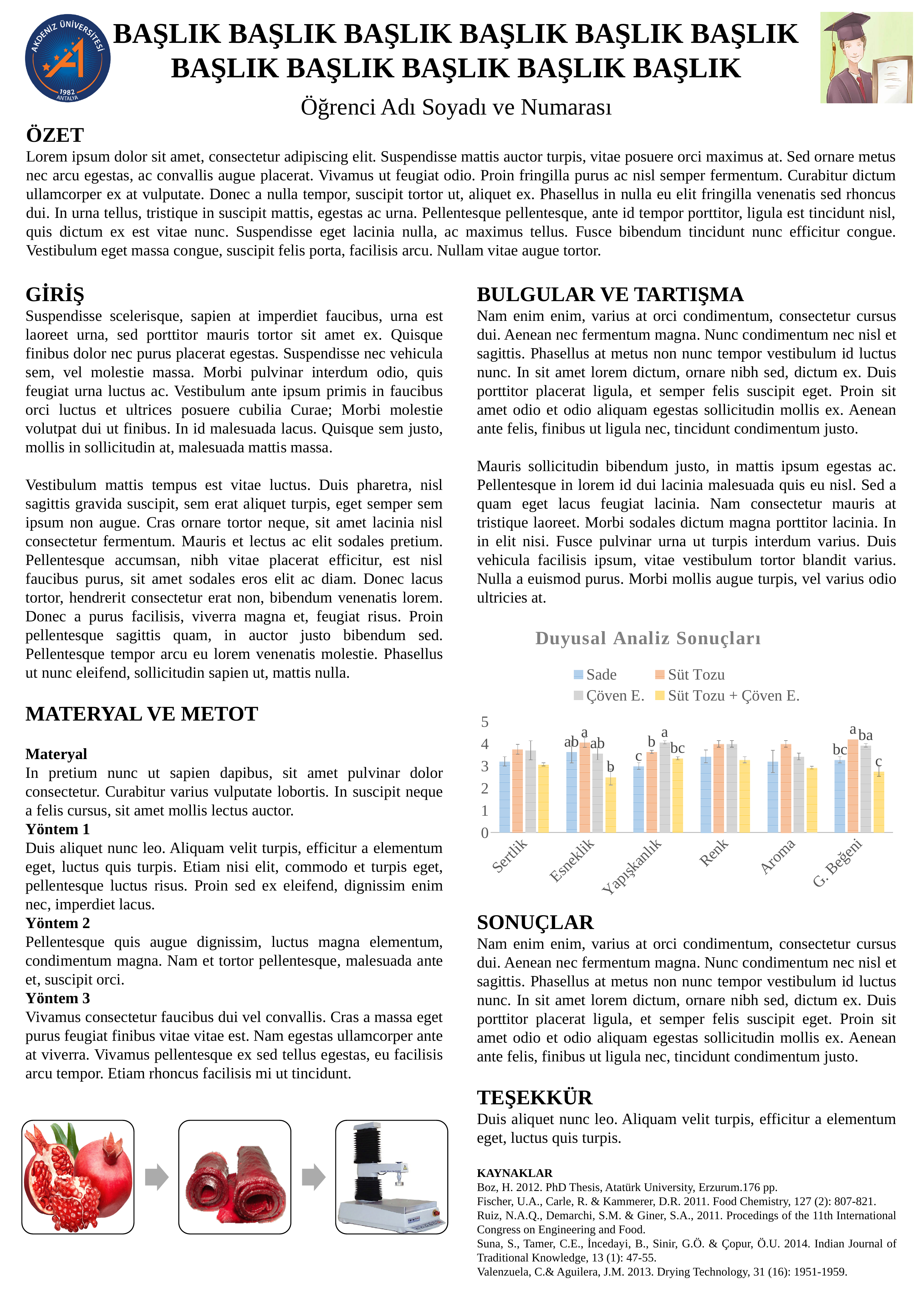
How many series does the legend of the chart list? 4 In the Yapışkanlık category, which series has the highest value? Çöven E. What is the title of the chart on the slide? Duyusal Analiz Sonuçları Is the value for Süt Tozu + Çöven E. in the Esneklik category greater or less than 3? less What kind of chart is shown under the title "Duyusal Analiz Sonuçları"? bar chart In the G. Beğeni category, which series has the lowest value? Süt Tozu + Çöven E. How many categories are shown on the x axis of the chart? 6 Is the value for Süt Tozu in the G. Beğeni category greater or less than 4? greater Which series are listed in the chart's legend? Sade, Süt Tozu, Çöven E., Süt Tozu + Çöven E. Is the value for Sade in the Sertlik category greater or less than 3? greater In the Esneklik category, which is larger: Süt Tozu or Süt Tozu + Çöven E.? Süt Tozu